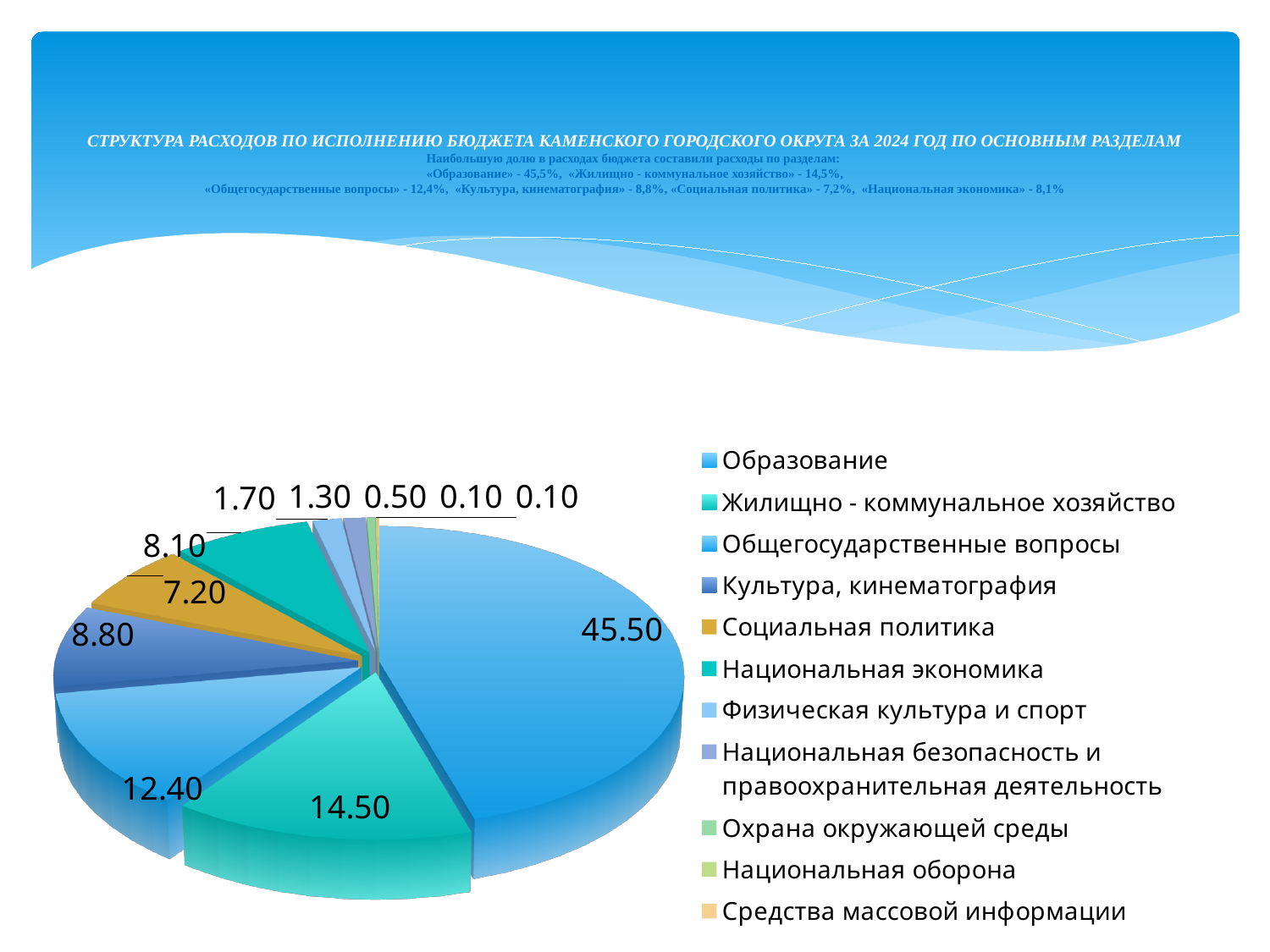
Which category has the largest slice of the pie? Образование What is the value shown for Физическая культура и спорт? 1.70 What share of the pie does Национальная экономика represent? 8.10 What is the value shown for Образование? 45.50 What is the value shown for Социальная политика? 7.20 What is the value shown for Общегосударственные вопросы? 12.40 What is the difference between the values for Общегосударственные вопросы and Культура, кинематография? 3.60 What is the value shown for Жилищно - коммунальное хозяйство? 14.50 Which is larger, Культура, кинематография or Национальная экономика? Культура, кинематография What is the difference between the values for Образование and Жилищно - коммунальное хозяйство? 31.00 How many categories are listed in the legend? 11 What type of chart is shown on the slide? Pie chart